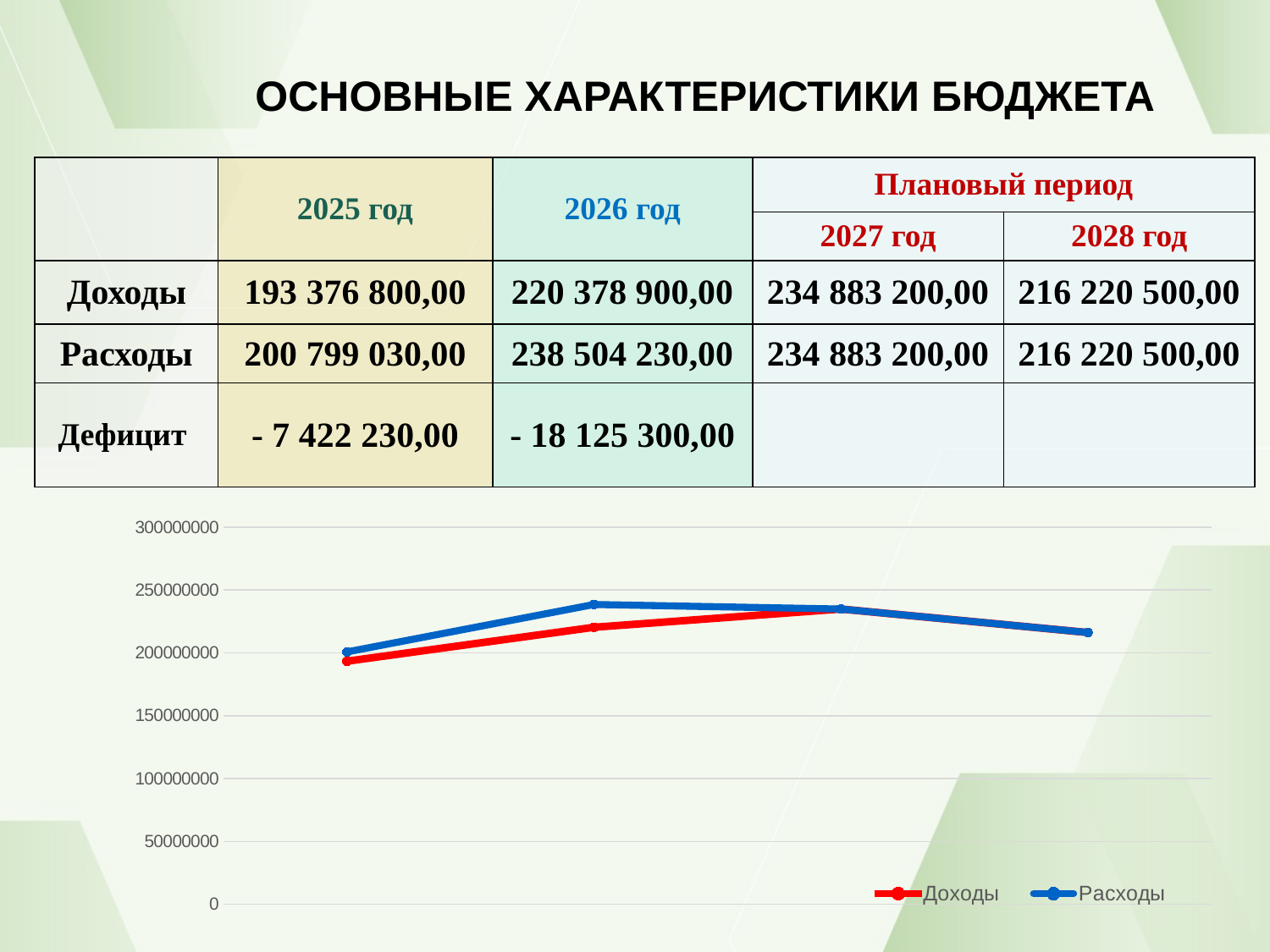
According to the table, what is the value of Доходы for 2026 год? 220 378 900,00 In the chart, does the Доходы line rise or fall from the first point to the third point? rise What kind of chart is shown below the table? line chart What colour is the Доходы line in the chart? red How many series does the chart legend list? 2 What are the two entries in the chart legend? Доходы and Расходы In the chart, is the highest point of the Расходы line greater or less than 250000000? less How many data points does each line in the chart have? 4 In the chart, is the second point of the Расходы line greater or less than 200000000? greater At the second point of the chart, which series is higher, Доходы or Расходы? Расходы According to the table, in which year are Расходы the highest? 2026 год According to the table, what is the value of Расходы for 2025 год? 200 799 030,00